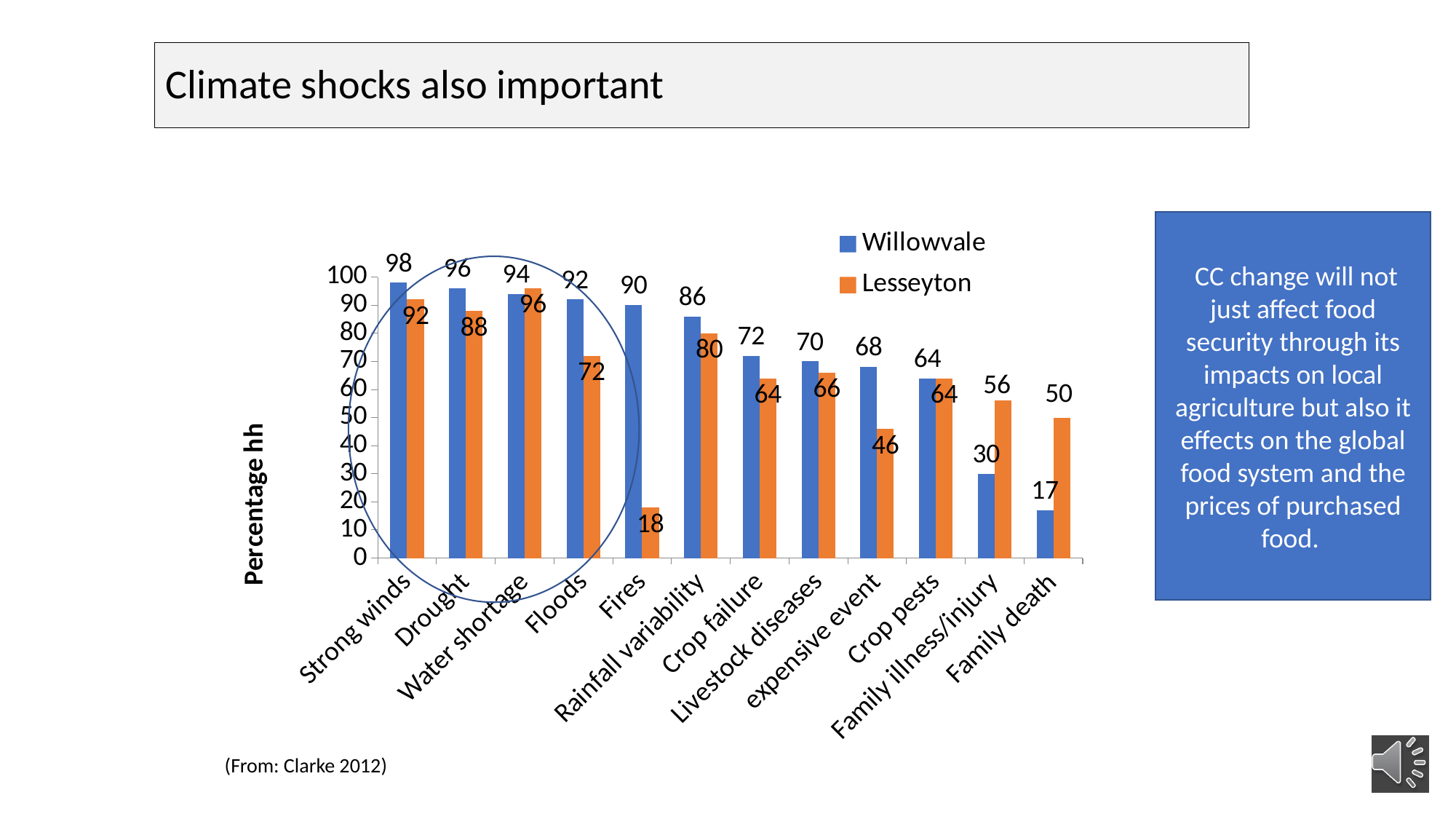
How many categories are shown on the x axis? 12 What is the Willowvale value for Strong winds? 98 What is the label on the vertical axis? Percentage hh What is the difference between the Willowvale and Lesseyton values for Fires? 72 What is the Lesseyton value for Fires? 18 Which category has the lowest Willowvale value? Family death How many series does the legend list? 2 What is the Lesseyton value for Water shortage? 96 For Family illness/injury, which is larger: the Willowvale value or the Lesseyton value? Lesseyton Which category has the highest Lesseyton value? Water shortage Do the Willowvale values rise or fall from Strong winds to Family death along the x axis? fall What kind of chart is shown on the slide? bar chart